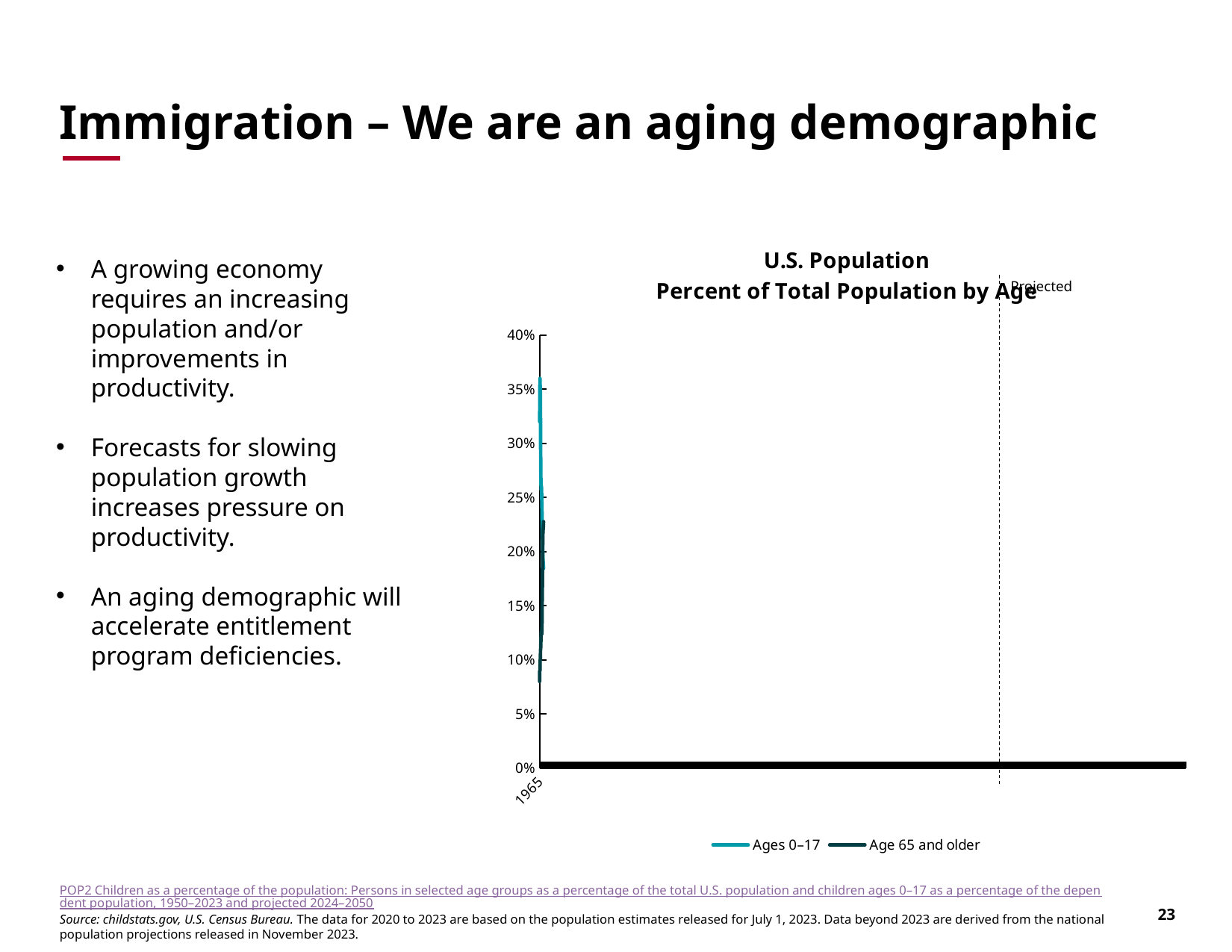
Is the highest plotted value for the Ages 0–17 series greater or less than 30%? greater What kind of chart is shown on the slide? line chart What is the title of the chart? U.S. Population Percent of Total Population by Age What are the two series named in the chart's legend? Ages 0–17 and Age 65 and older How many series does the legend of the chart list? 2